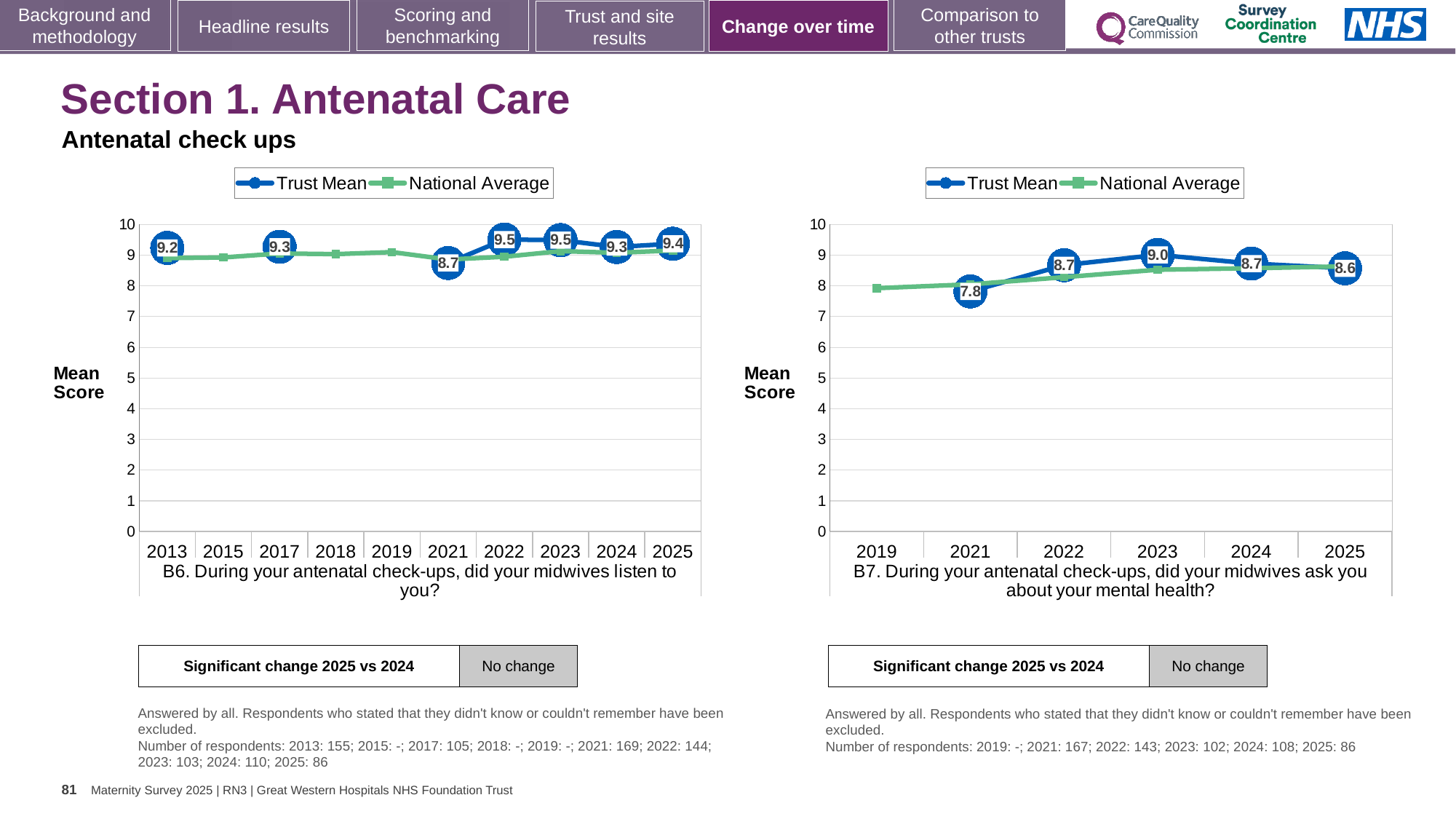
In the B6 chart (left), what is the Trust Mean for 2021? 8.7 In the B7 chart (right), what is the Trust Mean for 2021? 7.8 In the B7 chart (right), is the Trust Mean higher in 2022 or in 2021? 2022 In the B7 chart (right), which year has the highest Trust Mean? 2023 In the B6 chart (left), how many years are shown on the x axis? 10 In the B6 chart (left), which year has the lowest Trust Mean? 2021 In the B7 chart (right), is the National Average for 2019 greater or less than 9? less How many series does the legend of the B7 chart (right) list? 2 In the B6 chart (left), what is the Trust Mean for 2025? 9.4 What kind of chart is the B6 chart (left)? Line chart In the B6 chart (left), what is the difference between the Trust Mean in 2022 and in 2021? 0.8 In the B7 chart (right), what is the difference between the Trust Mean in 2023 and in 2021? 1.2